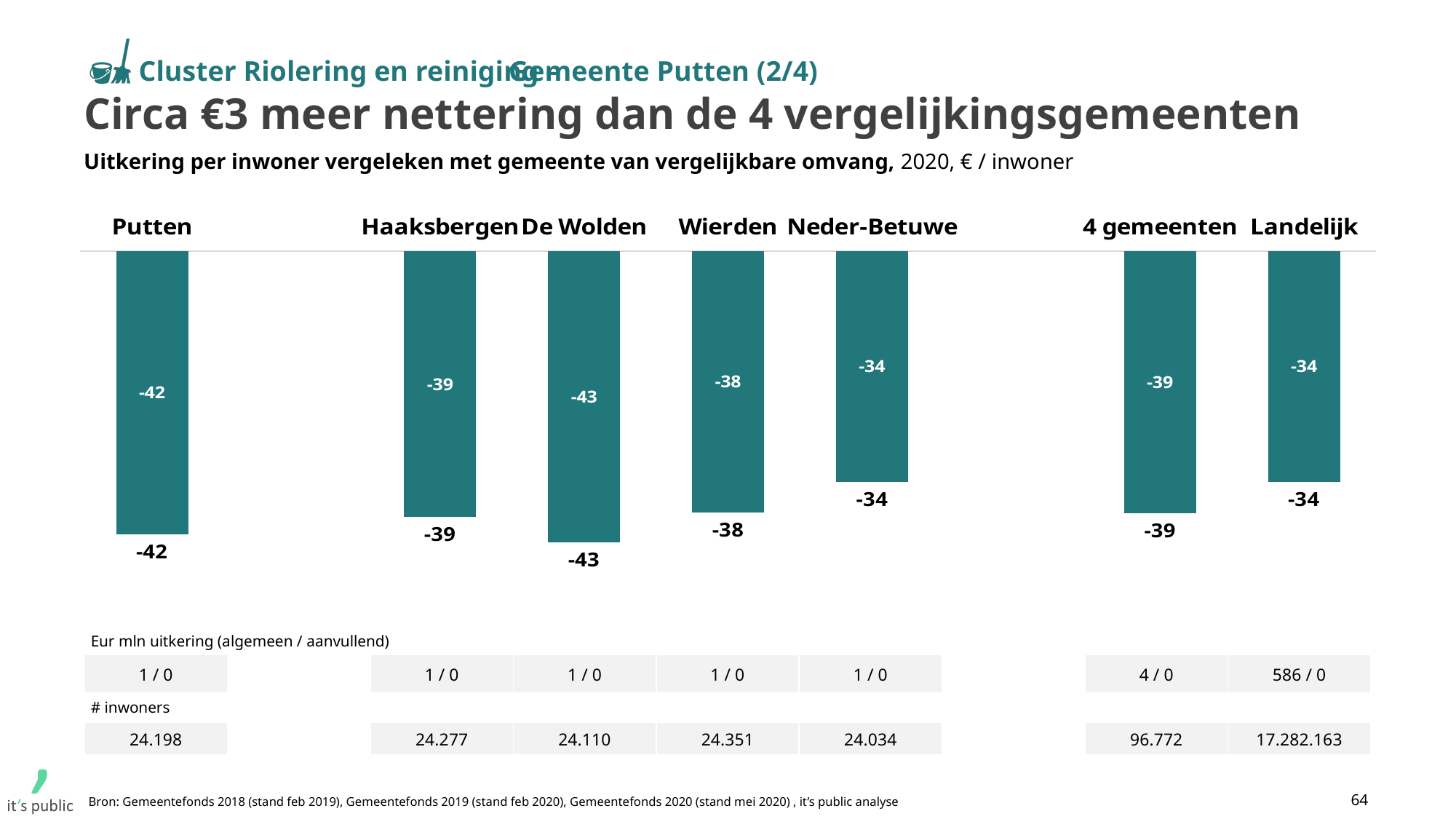
What is the difference between the values for Putten and 4 gemeenten? 3 Which category has the lowest (most negative) value in the chart? De Wolden How many categories (bars) are shown in the chart? 7 What is the value for 4 gemeenten in the chart? -39 What is the value for Putten in the chart? -42 What is the value for Neder-Betuwe in the chart? -34 Which has the lower value, Putten or Haaksbergen? Putten What is the difference between the values for Putten and Landelijk? 8 What is the value for De Wolden in the chart? -43 What is the value for Landelijk in the chart? -34 What kind of chart is shown on the slide? Bar chart What unit is stated in the chart subtitle for the values? € / inwoner